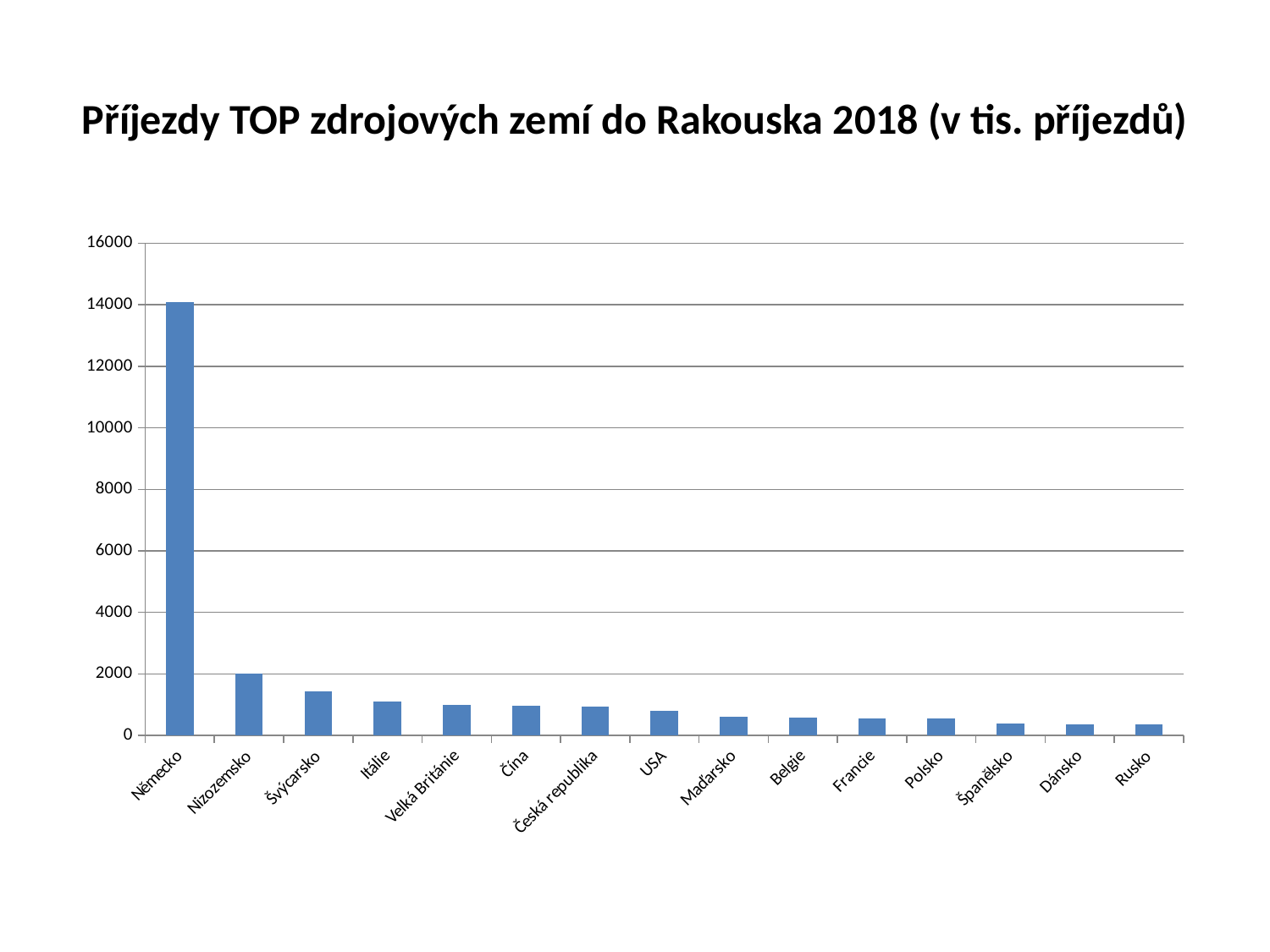
How many countries are shown on the x axis of the chart? 15 Which has a larger value, Švýcarsko or Itálie? Švýcarsko What is the title of the chart? Příjezdy TOP zdrojových zemí do Rakouska 2018 (v tis. příjezdů) Which country has the highest value in the chart? Německo What kind of chart is shown on the slide? bar chart Which has a larger value, Nizozemsko or Švýcarsko? Nizozemsko Is the value for Švýcarsko greater or less than 2000? less Is the value for Rusko greater or less than 2000? less Is the value for Německo greater or less than 12000? greater Which has a larger value, Německo or Nizozemsko? Německo Do the values generally rise or fall from left to right along the x axis? fall